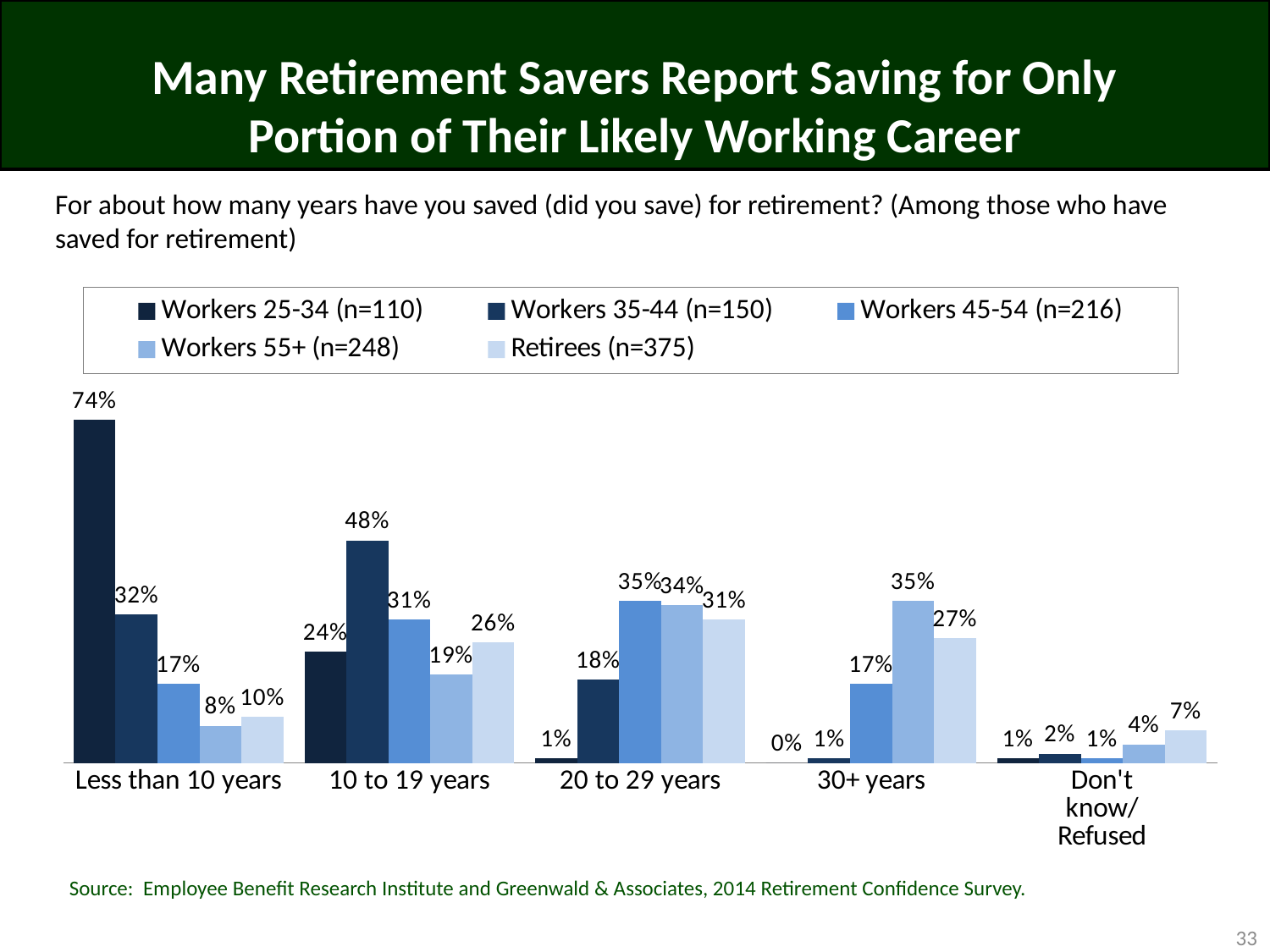
What type of chart is shown on the slide? Bar chart What percentage of Workers 55+ answered Don't know/Refused? 4% How many response categories are shown on the x axis? 5 What percentage of Workers 35-44 report saving for 10 to 19 years? 48% How many series does the legend list? 5 What is the sample size (n) for Retirees shown in the legend? 375 What percentage of Workers 25-34 report saving for less than 10 years? 74% What is the difference between Workers 25-34 and Workers 35-44 in the Less than 10 years category? 42 percentage points In the 20 to 29 years category, which is larger: Workers 45-54 or Retirees? Workers 45-54 What percentage of Retirees report saving for 30+ years? 27% Which group has the highest value in the 30+ years category? Workers 55+ (n=248) Which group has the lowest value in the Less than 10 years category? Workers 55+ (n=248)